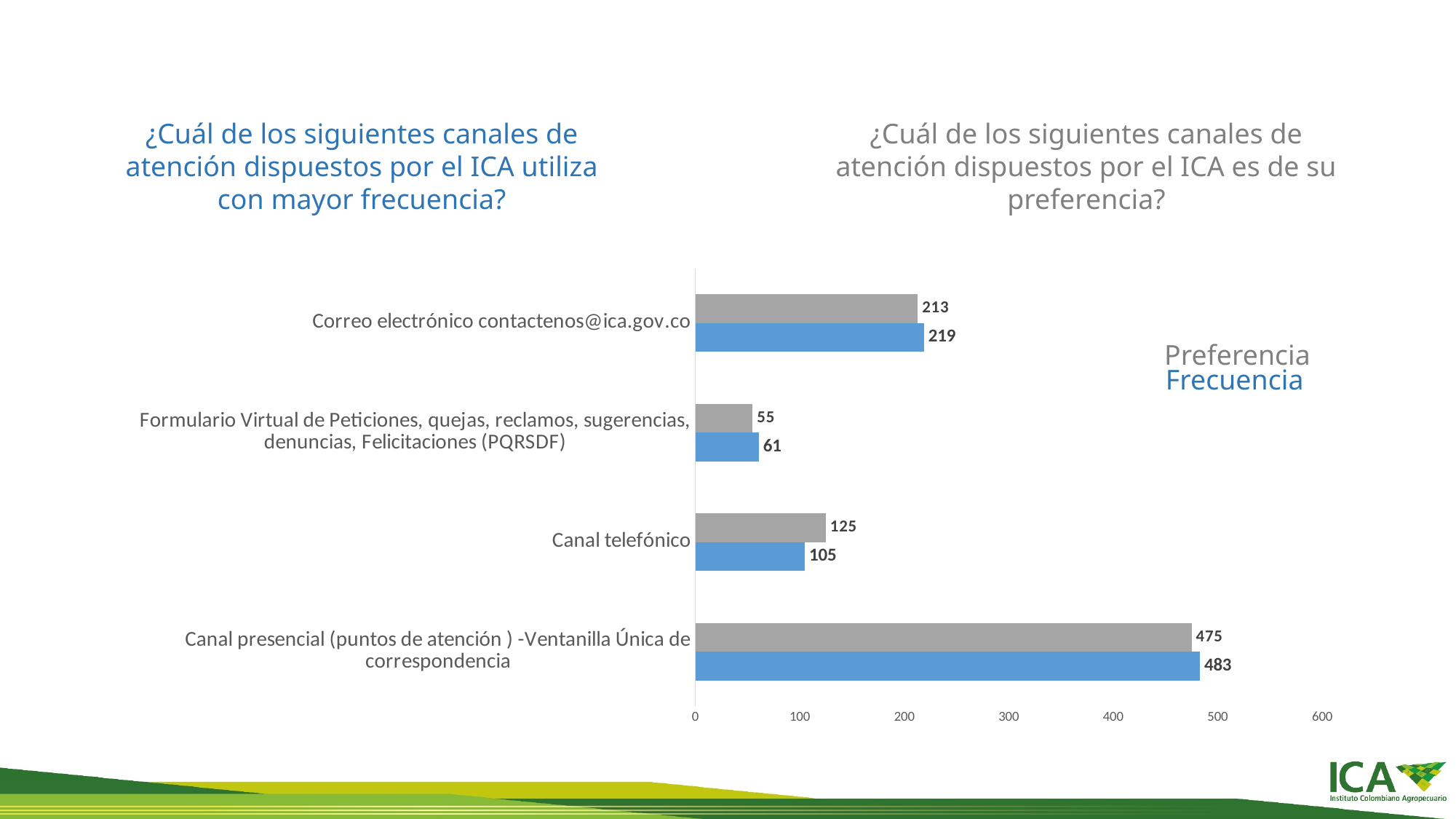
How many categories are shown on the chart? 4 How many series does the legend list? 2 What is the Frecuencia value for Formulario Virtual de Peticiones, quejas, reclamos, sugerencias, denuncias, Felicitaciones (PQRSDF)? 61 For Canal telefónico, which is larger: the Preferencia value or the Frecuencia value? Preferencia What is the difference between the Frecuencia and Preferencia values for Canal presencial (puntos de atención ) -Ventanilla Única de correspondencia? 8 Which category has the highest Frecuencia value? Canal presencial (puntos de atención ) -Ventanilla Única de correspondencia What kind of chart is shown on the slide? Bar chart Which category has the lowest Preferencia value? Formulario Virtual de Peticiones, quejas, reclamos, sugerencias, denuncias, Felicitaciones (PQRSDF) What is the Preferencia value for Correo electrónico contactenos@ica.gov.co? 213 What is the Frecuencia value for Canal telefónico? 105 Is the Preferencia value for Canal presencial (puntos de atención ) -Ventanilla Única de correspondencia greater or less than 400? greater Which colour represents the Frecuencia series? Blue